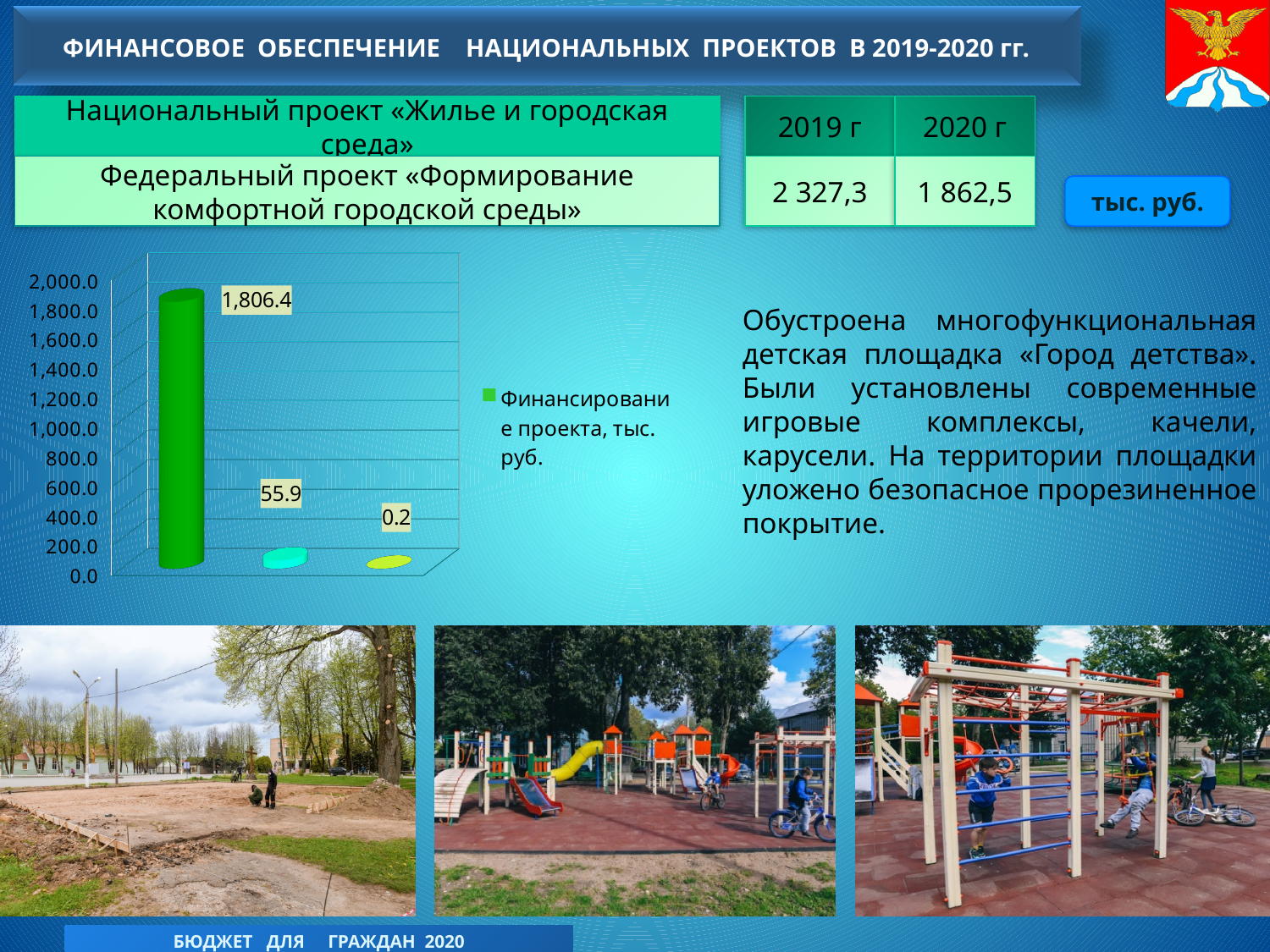
What is the legend entry of the chart? Финансирование проекта, тыс. руб. How many bars are plotted in the chart? 3 What is the value shown on the rightmost bar in the chart? 0.2 Do the bar values rise or fall from left to right across the chart? fall What is the value shown on the tallest (leftmost) bar in the chart? 1,806.4 What is the highest value plotted in the chart? 1,806.4 What is the value shown on the middle bar in the chart? 55.9 What is the lowest value plotted in the chart? 0.2 Which is larger, the middle bar or the rightmost bar? the middle bar (55.9) What is the difference between the leftmost bar (1,806.4) and the middle bar (55.9)? 1,750.5 How many series does the chart legend list? 1 What type of chart is shown on the slide? bar chart